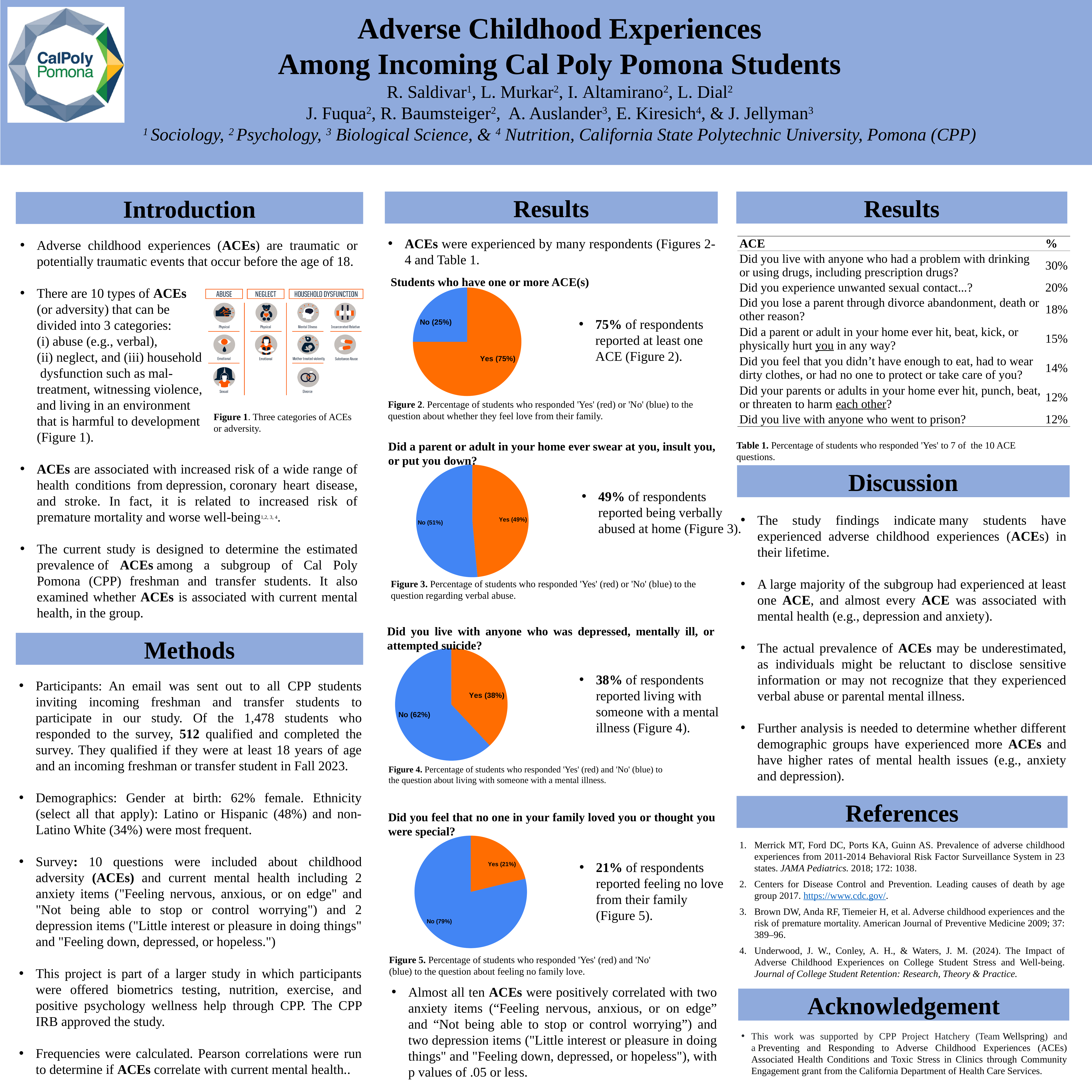
In the pie chart titled "Students who have one or more ACE(s)", what colour is the Yes slice? Orange In the pie chart titled "Students who have one or more ACE(s)", what percentage of students answered Yes? 75% In the pie chart for "Did a parent or adult in your home ever swear at you, insult you, or put you down?", what percentage answered No? 51% In the pie chart for "Did a parent or adult in your home ever swear at you, insult you, or put you down?", what percentage answered Yes? 49% In the pie chart for "Did you feel that no one in your family loved you or thought you were special?", what percentage answered No? 79% In the pie chart titled "Students who have one or more ACE(s)", what percentage of students answered No? 25% How many slices does the pie chart titled "Students who have one or more ACE(s)" have? 2 What kind of chart is used for "Students who have one or more ACE(s)"? Pie chart In the pie chart for "Did you live with anyone who was depressed, mentally ill, or attempted suicide?", which slice is larger, Yes or No? No In the pie chart for "Did you live with anyone who was depressed, mentally ill, or attempted suicide?", what is the difference between the No and Yes percentages? 24% In the pie chart for "Did you live with anyone who was depressed, mentally ill, or attempted suicide?", what percentage answered Yes? 38% In the pie chart for "Did you feel that no one in your family loved you or thought you were special?", what is the difference between the No and Yes percentages? 58%